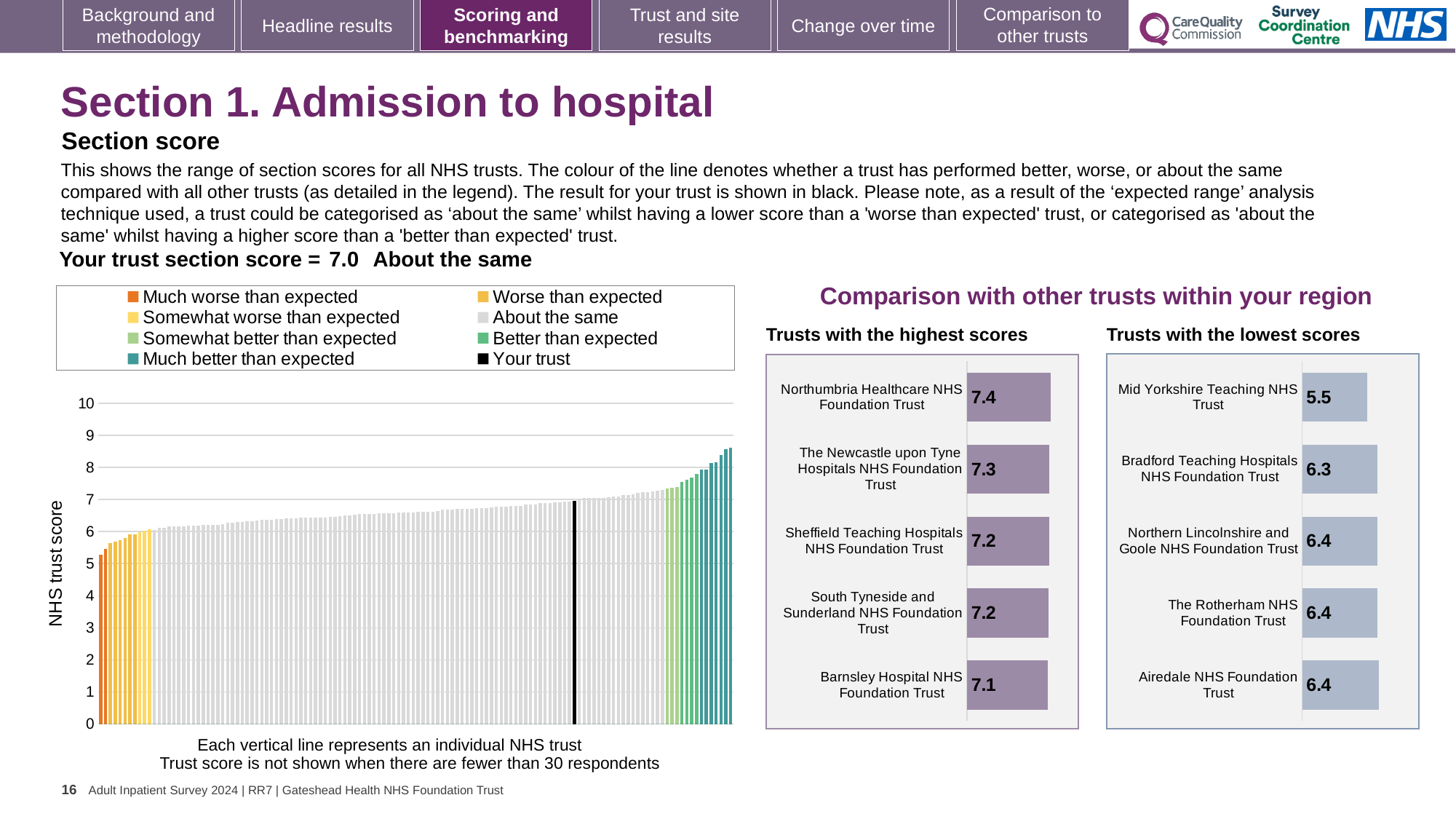
What kind of chart is the main NHS trust score chart on the left of the slide? bar chart In the main NHS trust score chart on the left, what is the section score for your trust (the black bar)? 7.0 In the 'Trusts with the highest scores' chart, what is the difference between the scores of Northumbria Healthcare NHS Foundation Trust and Barnsley Hospital NHS Foundation Trust? 0.3 In the 'Trusts with the lowest scores' chart, which trust has the lowest score? Mid Yorkshire Teaching NHS Trust In the main NHS trust score chart on the left, do the trust scores rise or fall from left to right? rise In the 'Trusts with the highest scores' chart, which trust has the highest score? Northumbria Healthcare NHS Foundation Trust In the 'Trusts with the highest scores' chart, what is the score for Northumbria Healthcare NHS Foundation Trust? 7.4 How many trusts are shown in the 'Trusts with the highest scores' chart? 5 In the 'Trusts with the highest scores' chart, which has the larger score: The Newcastle upon Tyne Hospitals NHS Foundation Trust or Sheffield Teaching Hospitals NHS Foundation Trust? The Newcastle upon Tyne Hospitals NHS Foundation Trust How many entries does the legend of the main NHS trust score chart on the left list? 8 In the 'Trusts with the lowest scores' chart, what is the score for Mid Yorkshire Teaching NHS Trust? 5.5 In the 'Trusts with the lowest scores' chart, how much higher is Bradford Teaching Hospitals NHS Foundation Trust's score than Mid Yorkshire Teaching NHS Trust's? 0.8